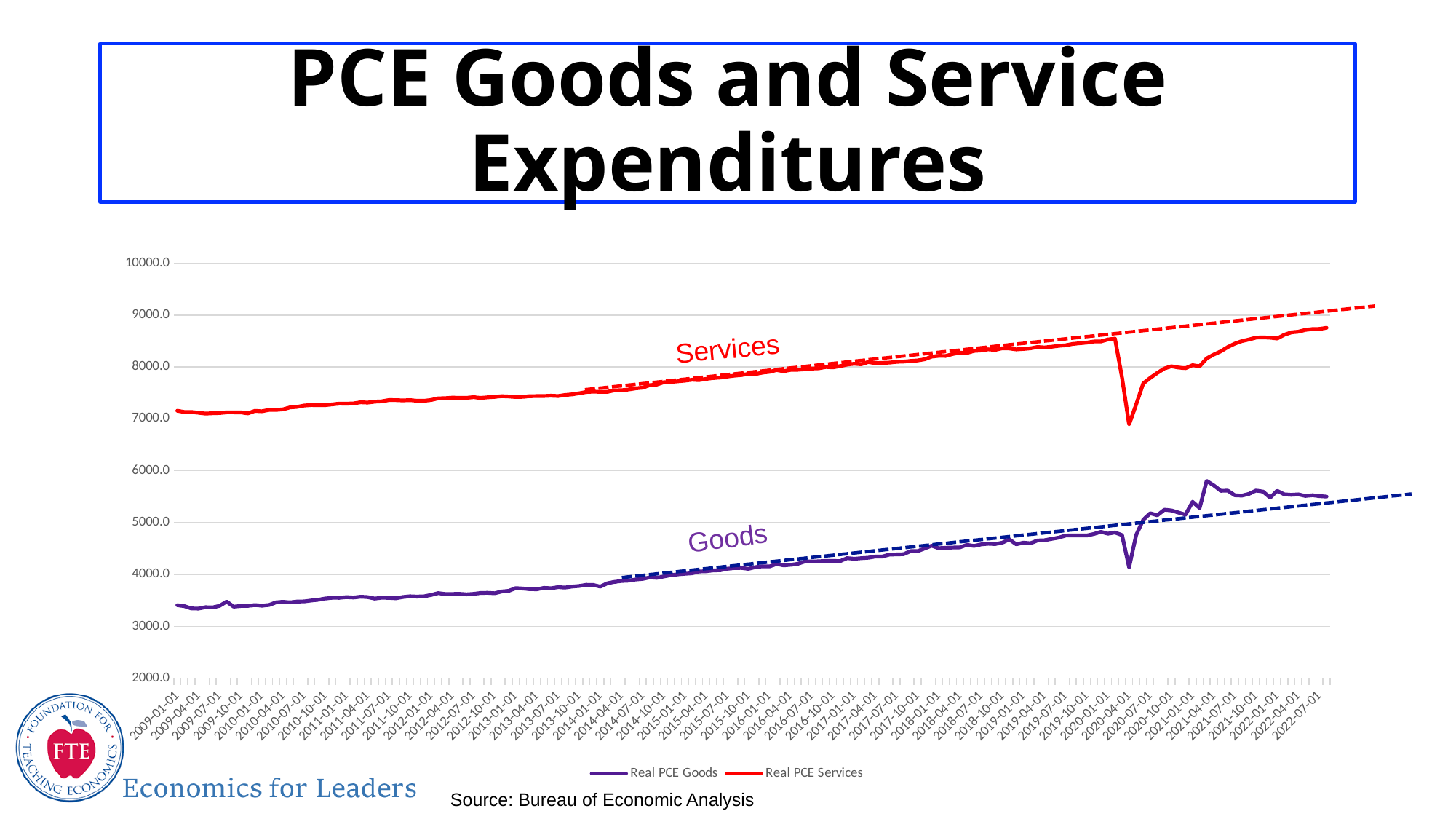
How many series does the chart legend list? 2 Over the full period from 2009 to 2022, do the Real PCE Services values generally rise or fall? rise Is the value for Real PCE Services at 2022-07-01 greater or less than 9000? less Is the value for Real PCE Services at 2020-04-01 greater or less than 7000? less What kind of chart is shown on the slide? line chart Is the value for Real PCE Goods at 2009-01-01 greater or less than 4000? less Which series has higher values throughout the chart, Real PCE Goods or Real PCE Services? Real PCE Services Which series is drawn in red on the chart? Real PCE Services What is the title of the slide containing the chart? PCE Goods and Service Expenditures What are the two series named in the chart legend? Real PCE Goods and Real PCE Services